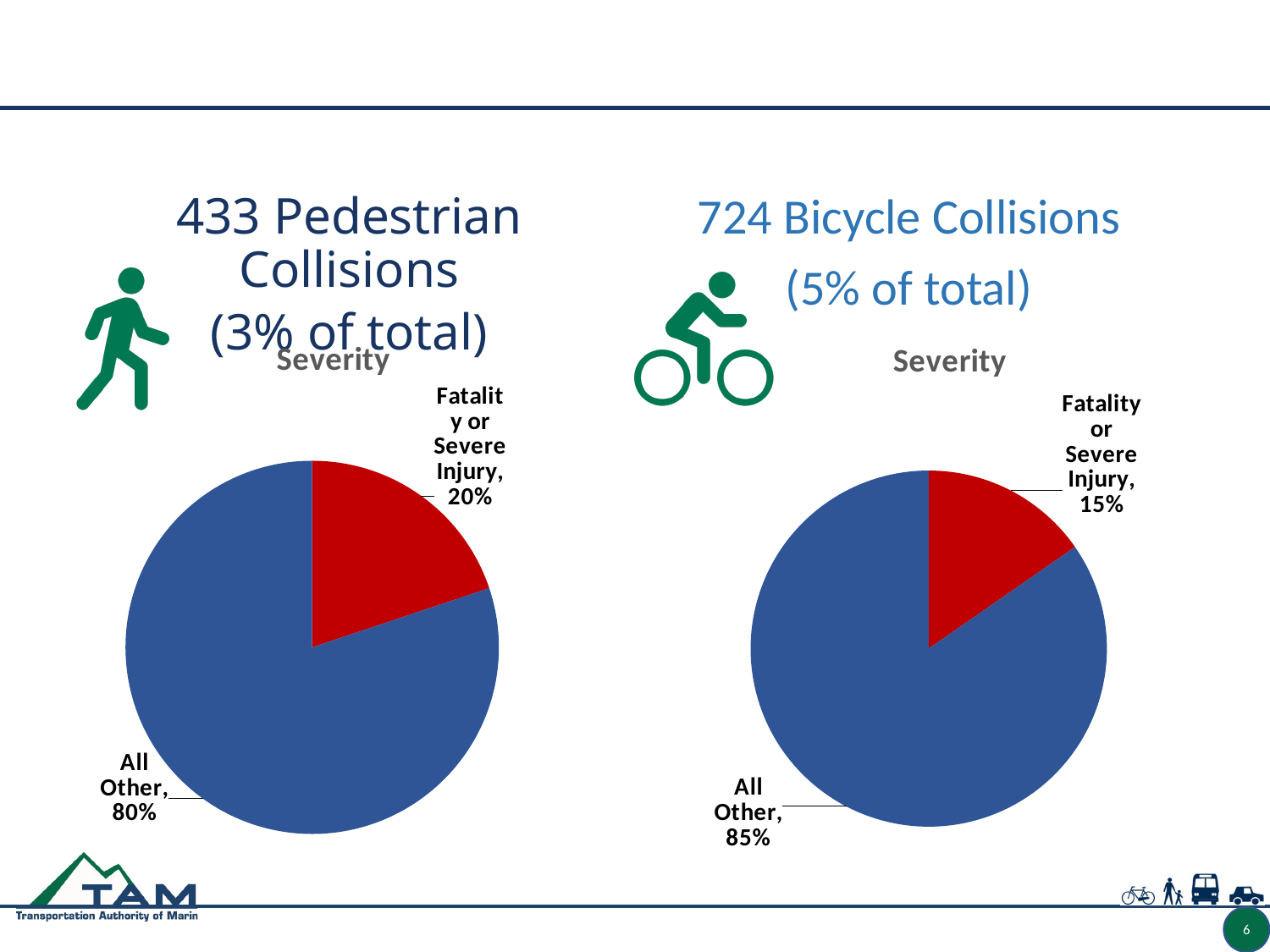
In the pedestrian collisions pie chart on the left, what share is labelled 'All Other'? 80% In the bicycle collisions pie chart on the right, what share is labelled 'Fatality or Severe Injury'? 15% In the pedestrian collisions pie chart on the left, what is the difference between the 'All Other' share and the 'Fatality or Severe Injury' share? 60% In the bicycle collisions pie chart on the right, which slice is the smallest? Fatality or Severe Injury In the pedestrian collisions pie chart on the left, which slice is the largest? All Other In the bicycle collisions pie chart on the right, what share is labelled 'All Other'? 85% In the pedestrian collisions pie chart on the left, what share is labelled 'Fatality or Severe Injury'? 20% In the bicycle collisions pie chart on the right, what colour is the 'Fatality or Severe Injury' slice? Red What is the title of the pie chart on the right? Severity Which chart shows a larger 'Fatality or Severe Injury' share, the pedestrian collisions chart on the left or the bicycle collisions chart on the right? Pedestrian collisions chart What type of chart is used for the pedestrian collisions severity on the left? Pie chart How many slices does the bicycle collisions pie chart on the right have? 2